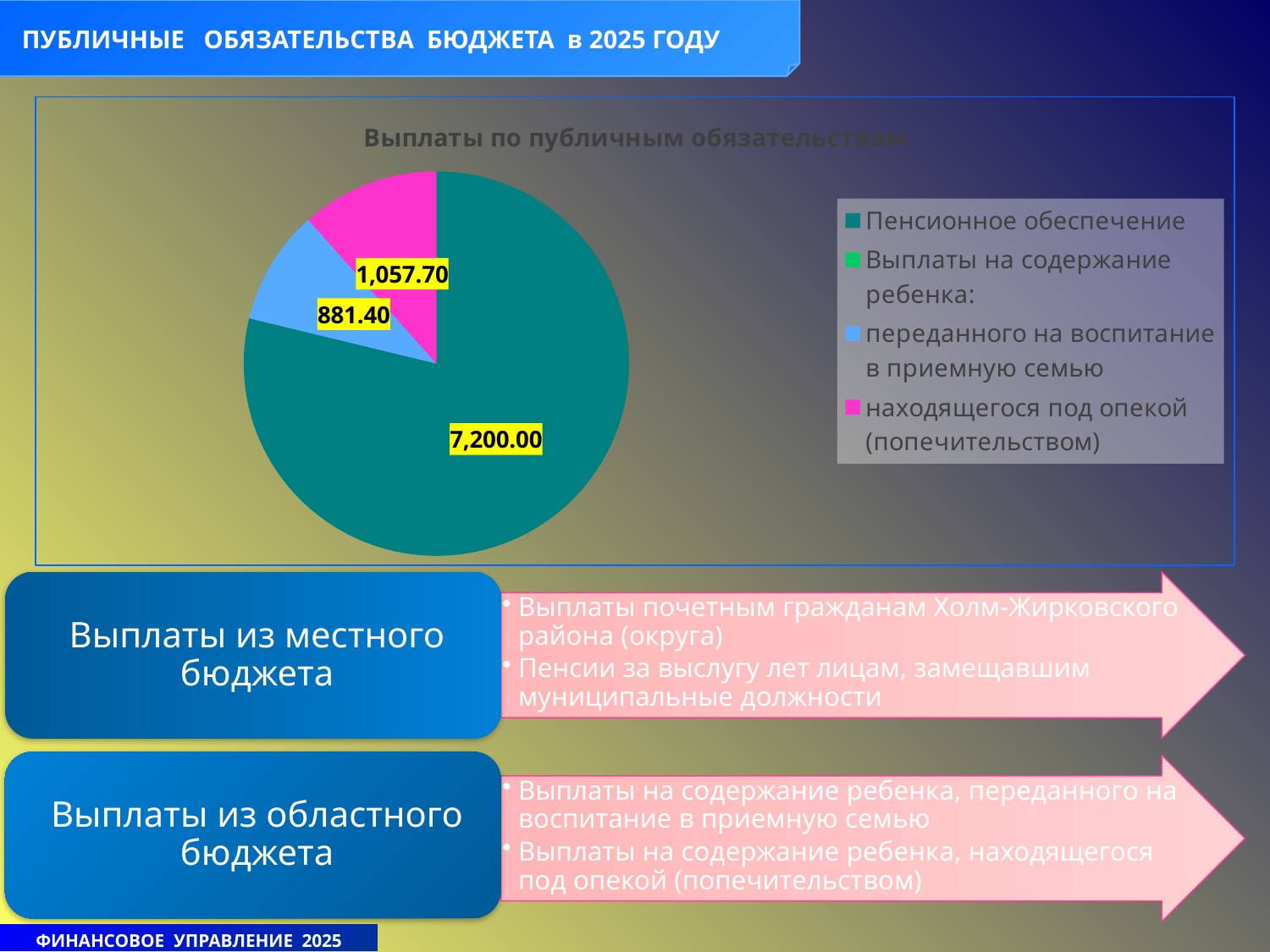
How many slices with data labels are shown in the pie chart? 3 Which labelled slice in the pie chart has the smallest value? переданного на воспитание в приемную семью What is the title of the pie chart? Выплаты по публичным обязательствам What is the value shown for Пенсионное обеспечение in the pie chart? 7,200.00 What is the difference between the value for Пенсионное обеспечение and the value for 'находящегося под опекой (попечительством)'? 6,142.30 What is the value shown for the slice 'находящегося под опекой (попечительством)'? 1,057.70 What type of chart is shown on the slide? Pie chart What is the difference between the value for 'находящегося под опекой (попечительством)' and the value for 'переданного на воспитание в приемную семью'? 176.30 How many entries does the chart legend list? 4 Which category has the largest slice in the pie chart? Пенсионное обеспечение Which is larger: the value for 'находящегося под опекой (попечительством)' or the value for 'переданного на воспитание в приемную семью'? находящегося под опекой (попечительством) What is the value shown for the slice 'переданного на воспитание в приемную семью'? 881.40